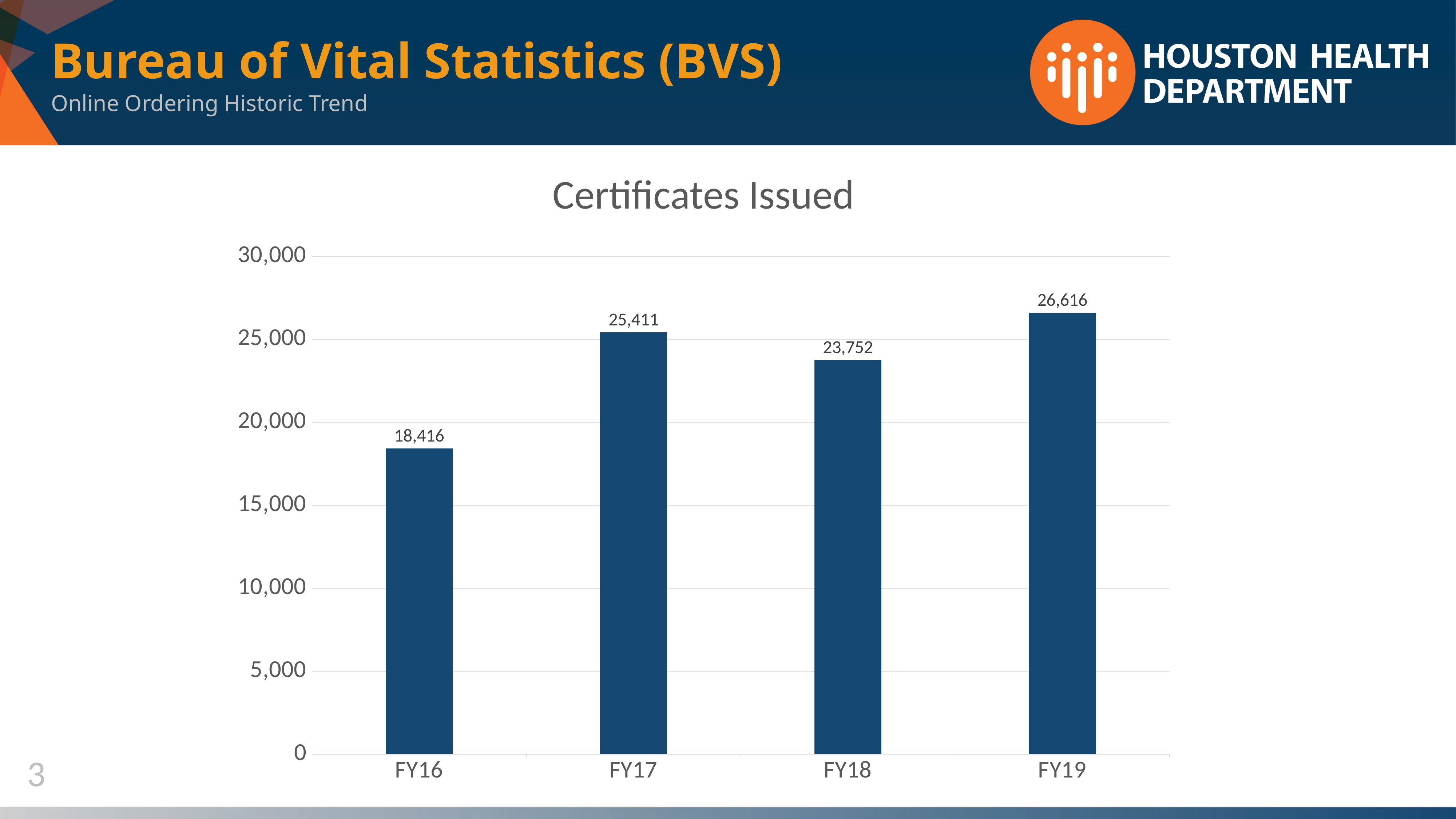
What type of chart is used to show certificates issued? Bar chart Which fiscal year had the highest number of certificates issued? FY19 How many certificates were issued in FY19? 26,616 Which fiscal year had the lowest number of certificates issued? FY16 What is the difference in certificates issued between FY19 and FY16? 8,200 How many fiscal years are shown on the chart? 4 What is the difference in certificates issued between FY17 and FY18? 1,659 How many certificates were issued in FY18? 23,752 Which year had more certificates issued, FY17 or FY18? FY17 How many certificates were issued in FY16? 18,416 What is the title of the chart? Certificates Issued How many certificates were issued in FY17? 25,411